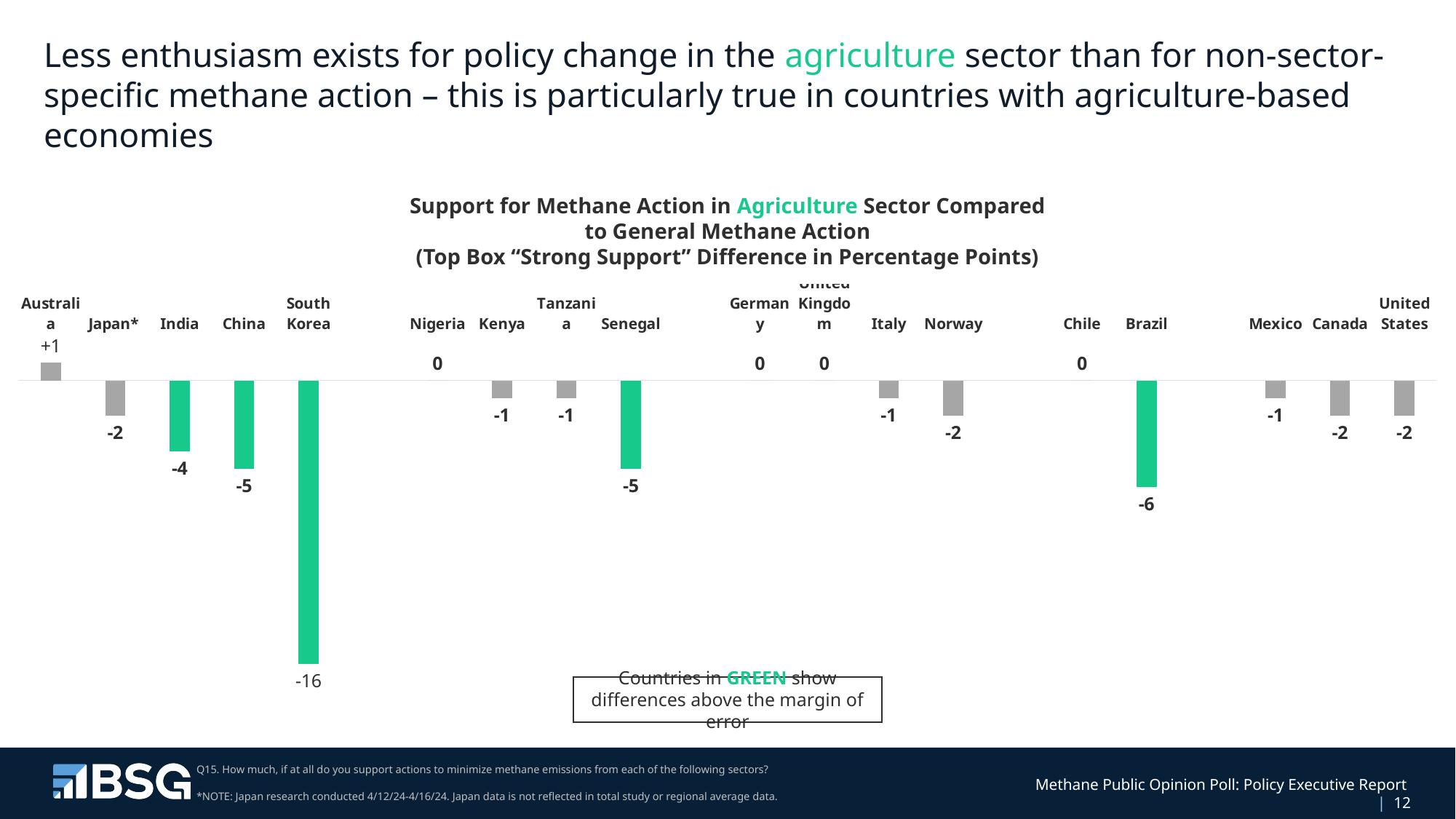
How many countries are shown on the chart? 18 How many countries show a value of 0? 4 According to the note on the chart, what do countries shown in green indicate? Differences above the margin of error What is the value shown for Brazil? -6 What is the value shown for Senegal? -5 What is the value shown for Australia? +1 Which country has the lowest (most negative) value on the chart? South Korea Which country has the highest value on the chart? Australia What is the difference between the values for South Korea and Brazil? 10 What kind of chart is shown on the slide? Bar chart What is the value shown for South Korea? -16 Which has a larger (less negative) value, India or China? India